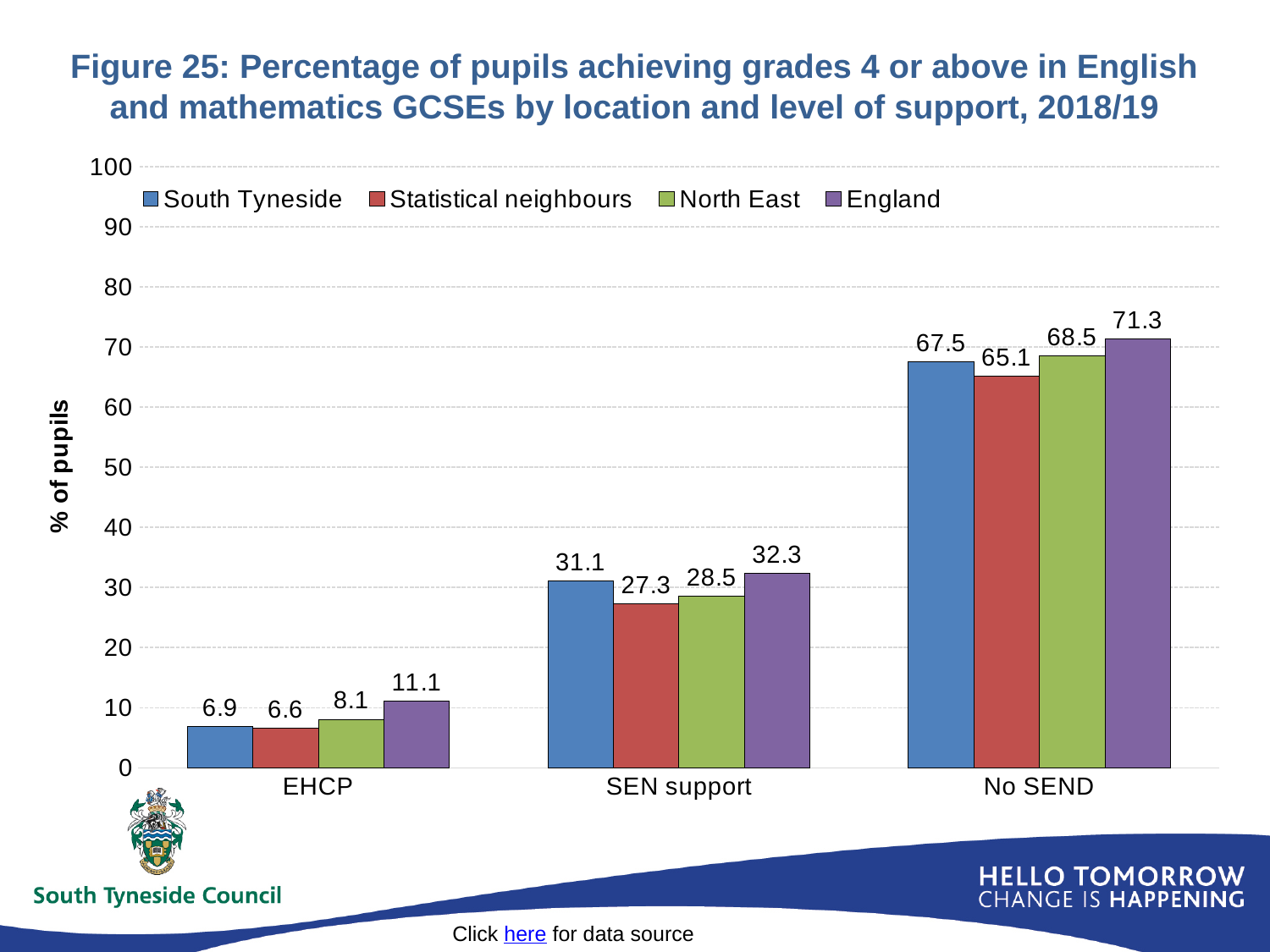
Which is larger: the North East value for SEN support or the Statistical neighbours value for SEN support? North East Do the South Tyneside values rise or fall from EHCP to No SEND? Rise What is the label of the y axis? % of pupils How many categories are shown on the x axis? 3 Which series has the highest value in the No SEND category? England What kind of chart is shown on the slide? Bar chart What is the value for England in the SEN support category? 32.3 What is the difference between the England and South Tyneside values in the EHCP category? 4.2 What is the value for South Tyneside in the EHCP category? 6.9 Which series has the lowest value in the SEN support category? Statistical neighbours How many series does the legend list? 4 What is the value for Statistical neighbours in the No SEND category? 65.1